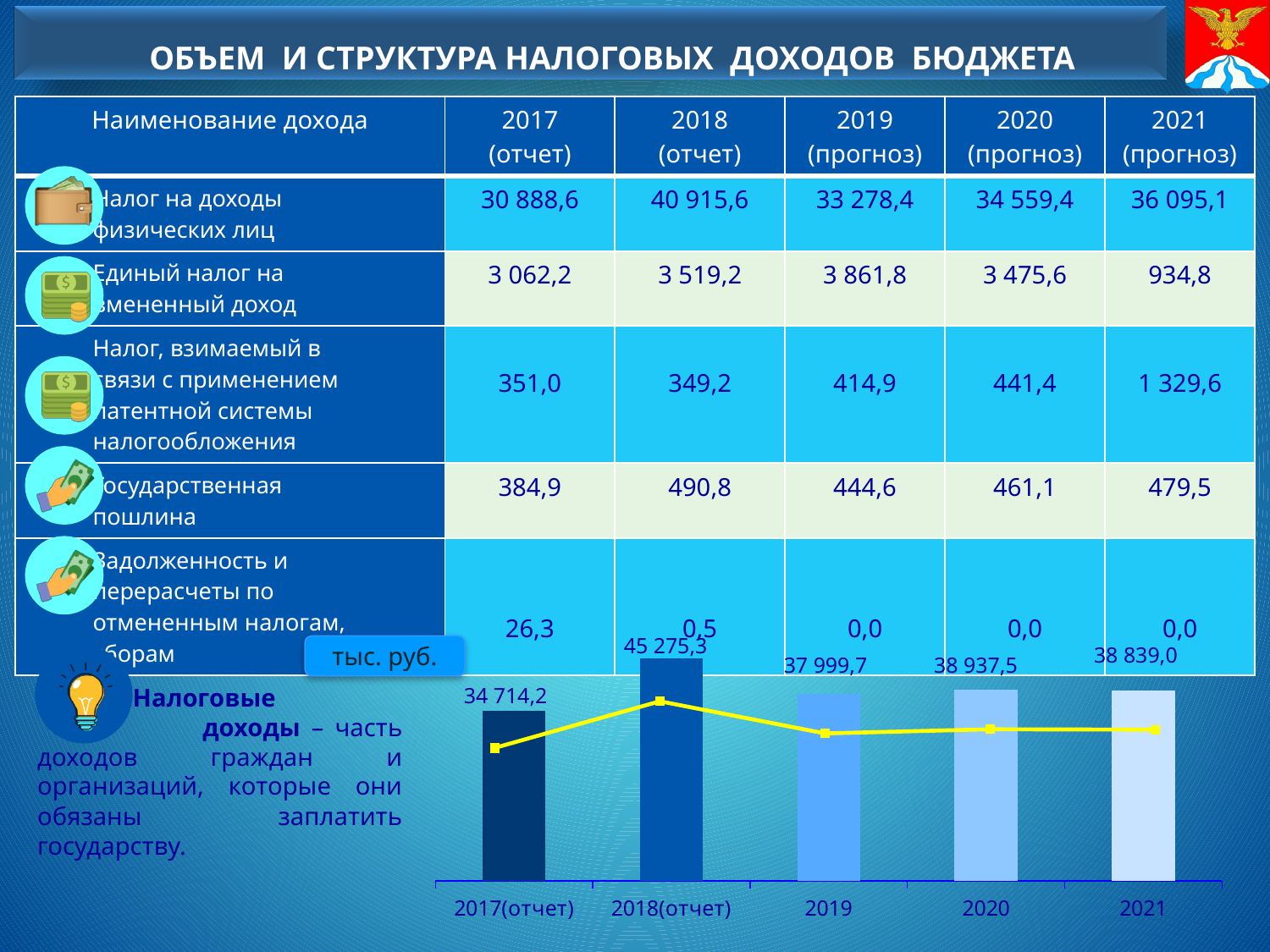
What is the value shown for 2019 in the chart? 37 999,7 What is the value shown for 2017(отчет) in the chart? 34 714,2 What is the difference between the values for 2018(отчет) and 2017(отчет) in the chart? 10 561,1 Which is larger in the chart, the value for 2019 or the value for 2020? 2020 What is the value shown for 2021 in the chart? 38 839,0 What is the difference between the values for 2020 and 2019 in the chart? 937,8 Which year has the lowest value in the chart? 2017(отчет) What kind of chart is shown at the bottom of the slide? Bar chart with a line How many years are shown on the x axis of the chart? 5 Does the value rise or fall from 2017(отчет) to 2018(отчет) in the chart? Rise What is the value shown for 2018(отчет) in the chart? 45 275,3 Which year has the highest value in the chart? 2018(отчет)